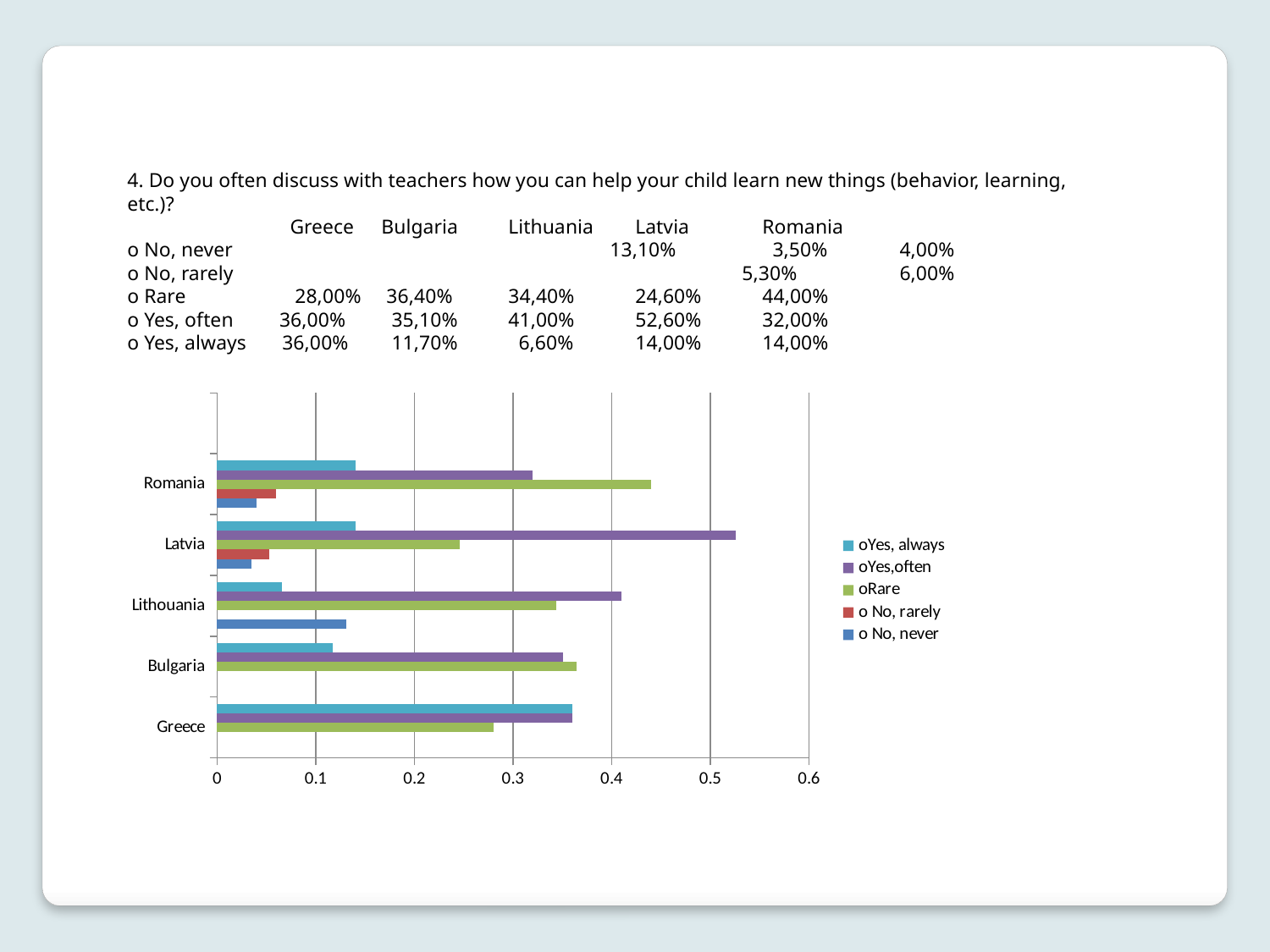
What is the difference between Romania's 'Rare' value and its 'Yes, often' value? 12,00% What colour represents the 'Rare' series in the chart legend? green How many countries are shown on the chart's vertical axis? 5 Which country has the highest 'Yes, often' value? Latvia Which country has the lowest 'Yes, always' value? Lithuania Is the 'Yes, often' bar for Latvia greater or less than 0.5? greater What kind of chart is shown on the slide? bar chart According to the slide, what is the 'Yes, often' value for Latvia? 52,60% Which country has the highest 'Rare' value? Romania How many series does the chart's legend list? 5 According to the slide, what is the 'Rare' value for Romania? 44,00% Which is larger, the 'Rare' value for Greece or for Bulgaria? Bulgaria